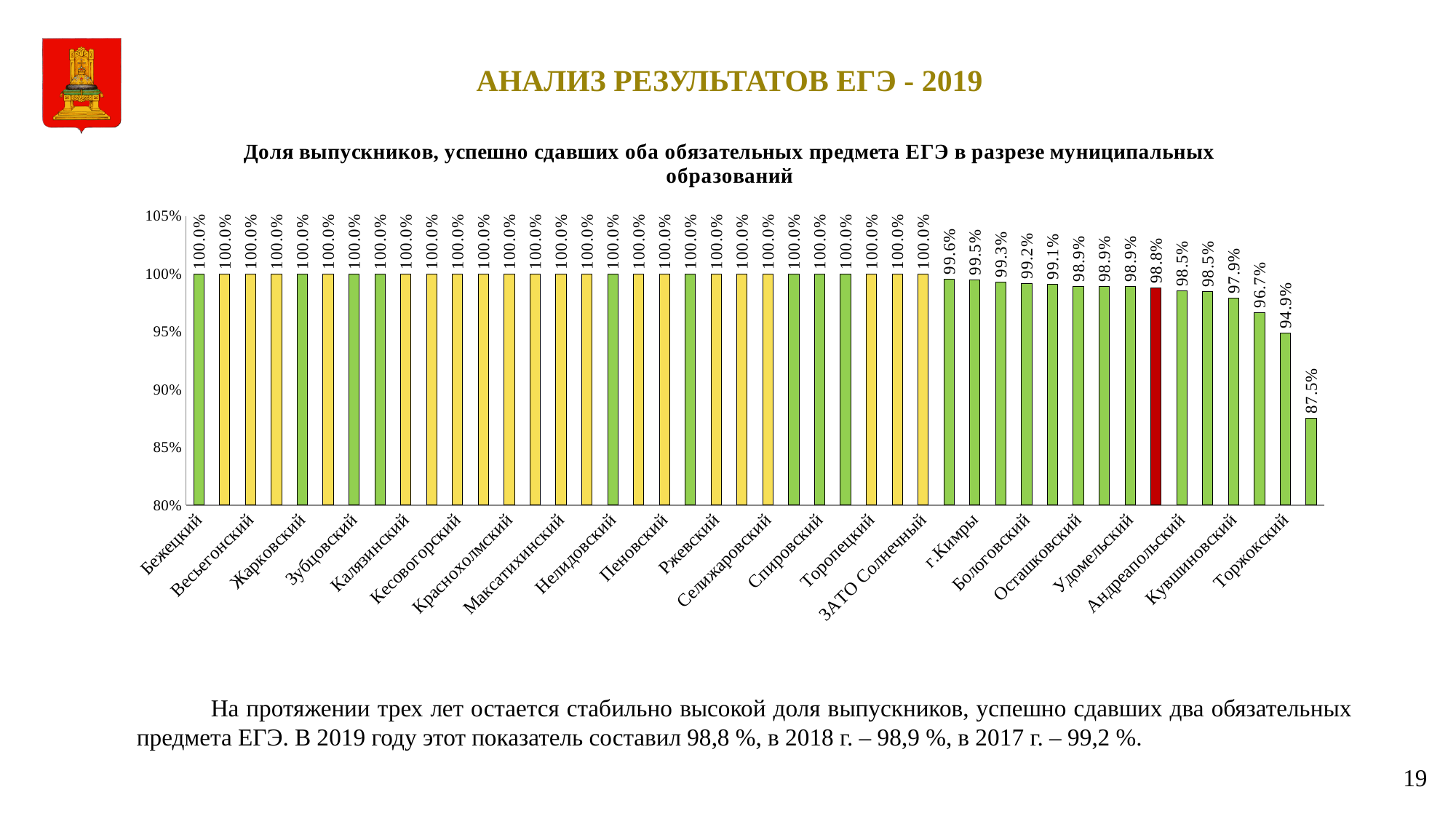
What is the value for Торжокский? 94.9% Is the value for Торжокский greater or less than 95%? less What is the highest value shown on the chart? 100.0% What is the value for Бологовский? 99.2% What is the value for г.Кимры? 99.5% What is the value for Кувшиновский? 97.9% What kind of chart is shown on the slide? bar chart What is the difference between the values for Кувшиновский and Торжокский? 3.0% Do the values rise or fall from left to right along the x axis? fall What is the lowest value shown on the chart? 87.5% What is the value for Бежецкий? 100.0% Which is larger, the value for Бологовский or the value for Андреапольский? Бологовский